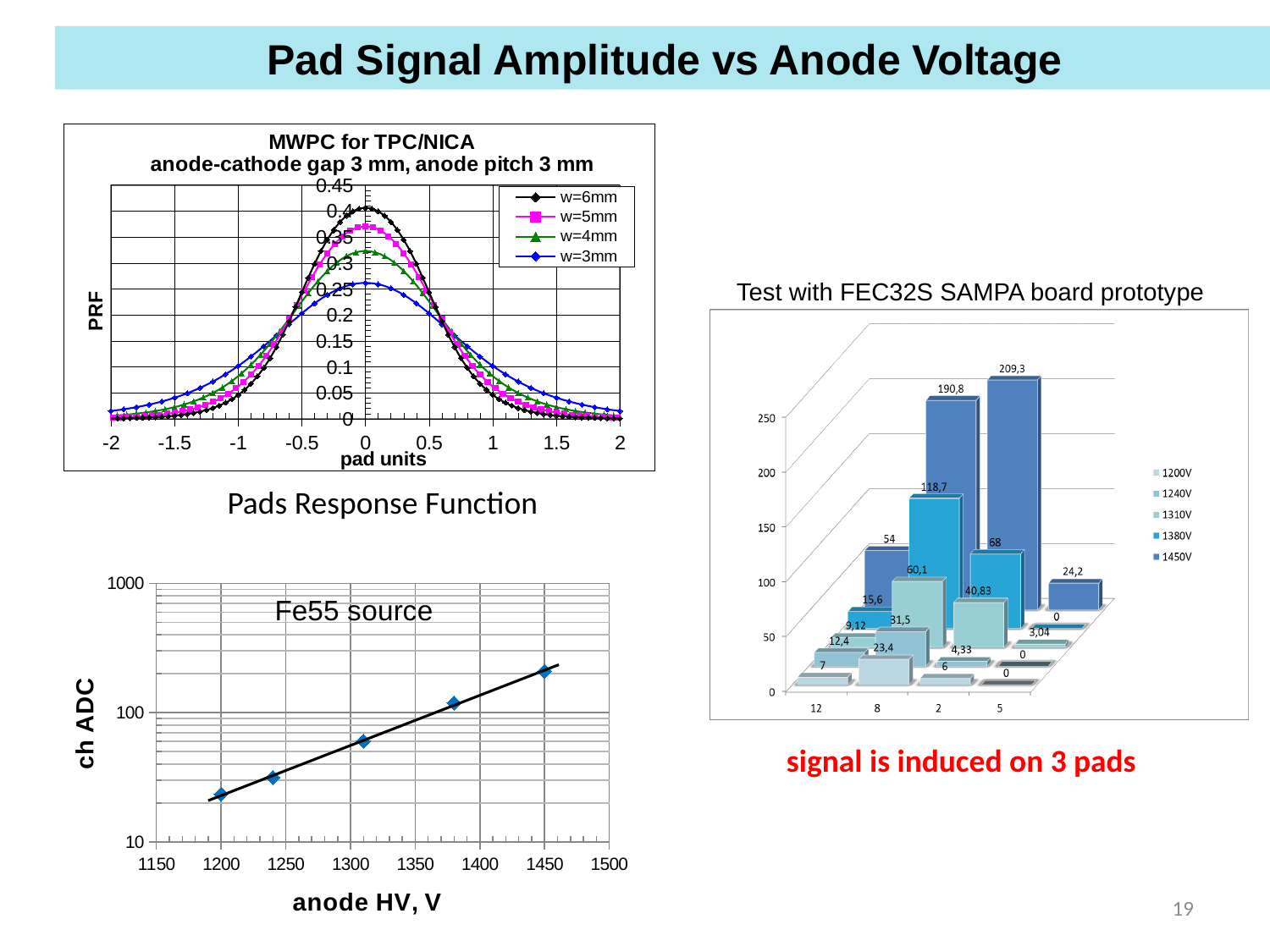
In the bottom-left chart labelled 'Fe55 source', is the ch ADC value at 1450 V greater or less than 100? greater In the right-hand chart 'Test with FEC32S SAMPA board prototype', what kind of chart is it? bar chart In the right-hand chart 'Test with FEC32S SAMPA board prototype', how many series does the legend list? 5 In the top-left chart titled 'MWPC for TPC/NICA', how many series does the legend list? 4 In the top-left chart titled 'MWPC for TPC/NICA', what kind of chart is it? line chart In the top-left chart titled 'MWPC for TPC/NICA', which series has the highest peak at 0 pad units? w=6mm In the top-left chart titled 'MWPC for TPC/NICA', which series has the lowest peak at 0 pad units? w=3mm In the top-left chart titled 'MWPC for TPC/NICA', is the PRF value of the w=6mm series at 0 pad units greater or less than 0.35? greater In the right-hand chart 'Test with FEC32S SAMPA board prototype', what is the highest labelled value? 209,3 In the bottom-left chart labelled 'Fe55 source', do the ch ADC values rise or fall as anode HV increases? rise In the right-hand chart 'Test with FEC32S SAMPA board prototype', what is the difference between the two largest labelled values, 209,3 and 190,8? 18,5 In the bottom-left chart labelled 'Fe55 source', how many data points are plotted? 5